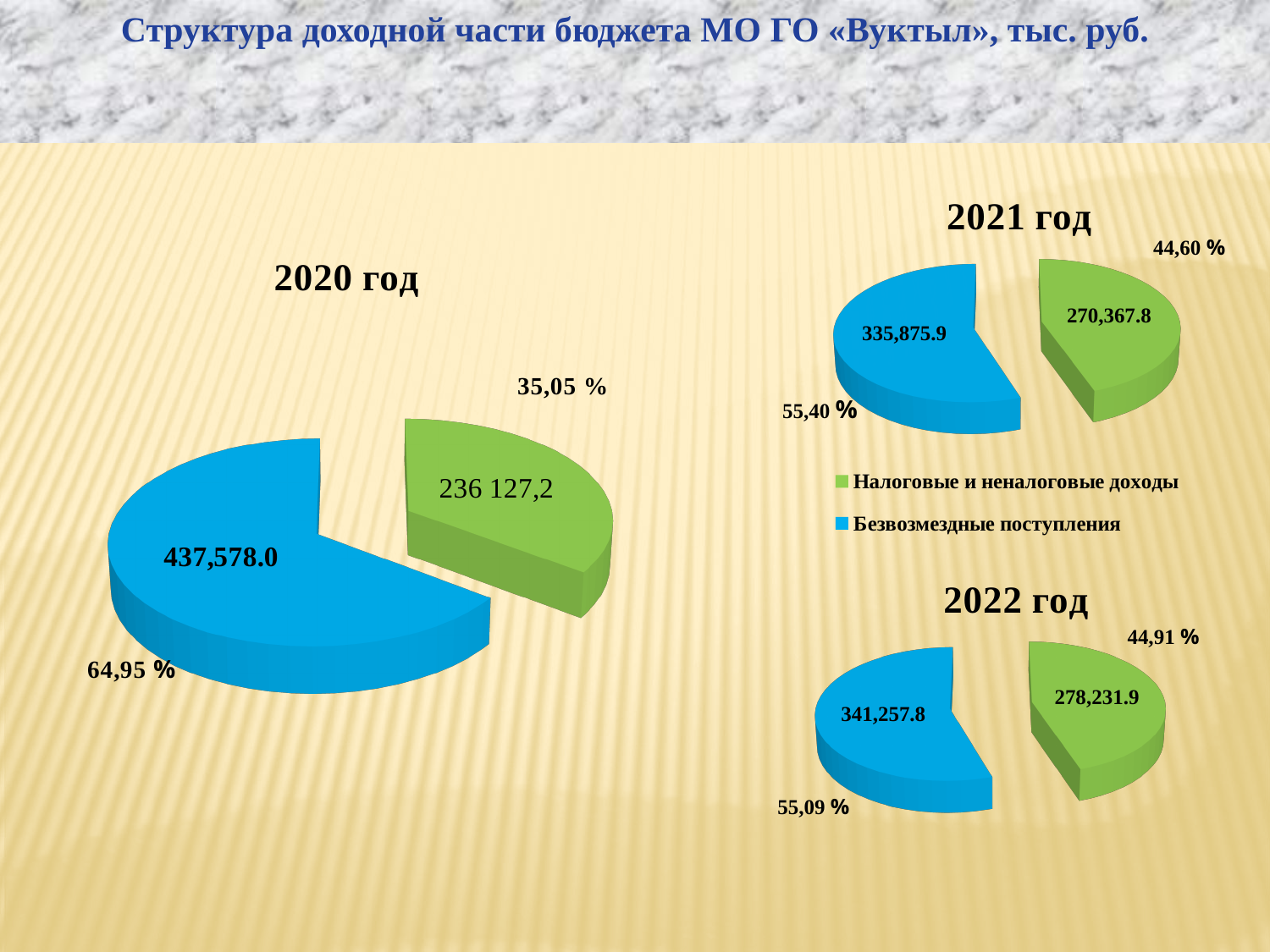
Which colour represents Безвозмездные поступления in the legend? Blue In the 2021 год chart, what value is shown for Налоговые и неналоговые доходы? 270,367.8 In the 2020 год chart, what share of the pie is Безвозмездные поступления? 64,95 % In the 2020 год chart, what value is shown for Безвозмездные поступления? 437,578.0 In the 2021 год chart, which category is the smallest? Налоговые и неналоговые доходы How many categories does the legend list? 2 In the 2021 год chart, what share of the pie is Налоговые и неналоговые доходы? 44,60 % In the 2022 год chart, which category is the largest? Безвозмездные поступления In the 2022 год chart, what share of the pie is Безвозмездные поступления? 55,09 % In the 2020 год chart, what value is shown for Налоговые и неналоговые доходы? 236 127,2 In the 2022 год chart, what value is shown for Безвозмездные поступления? 341,257.8 What kind of chart is used for 2020 год? Pie chart